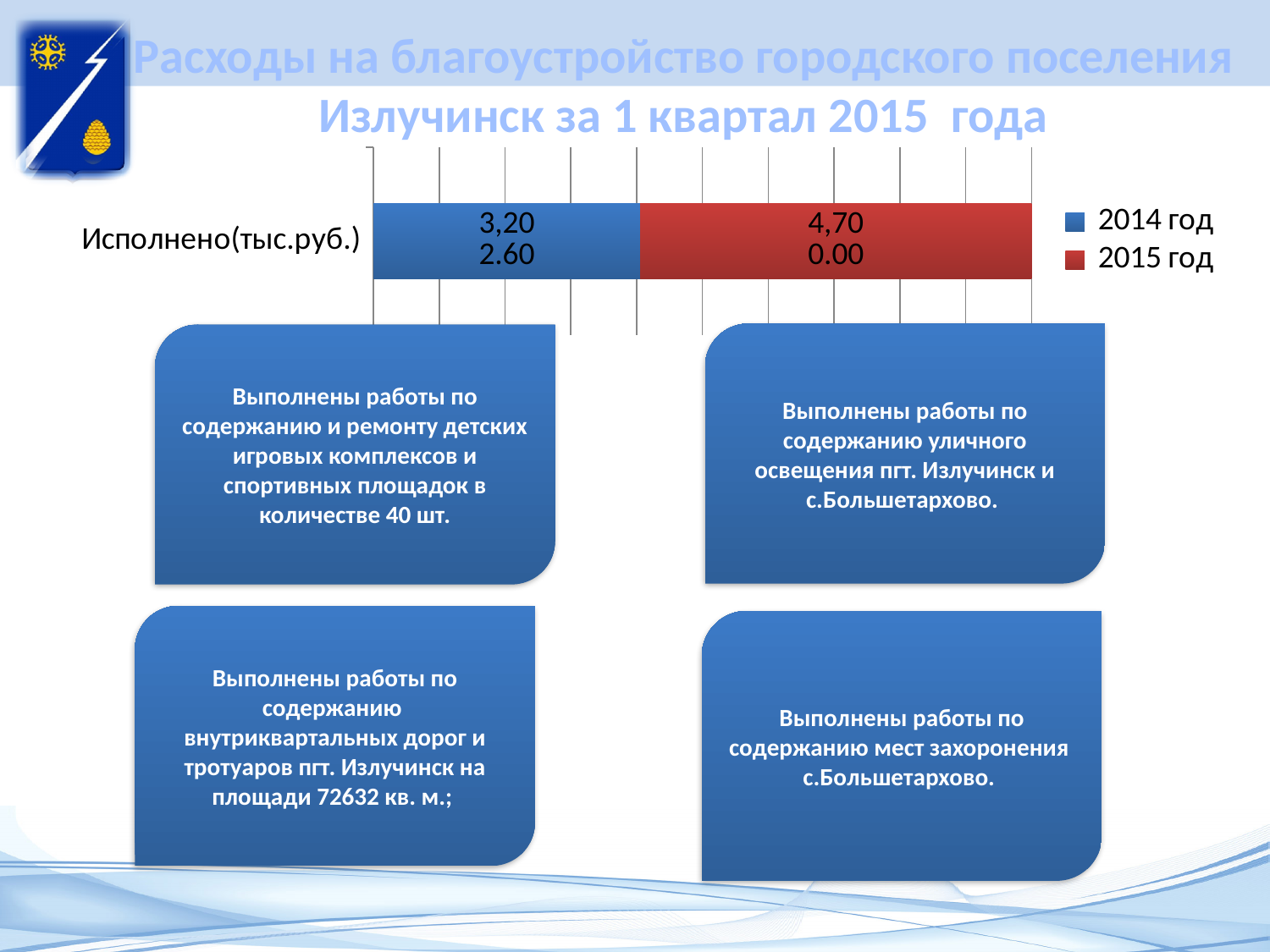
Which series has the longer bar segment, 2014 год or 2015 год? 2015 год How many categories are plotted on the chart's category axis? 1 What kind of chart is shown on the slide? bar chart Which colour represents the 2014 год series in the chart? blue What are the two entries in the chart legend? 2014 год and 2015 год How many series does the chart legend list? 2